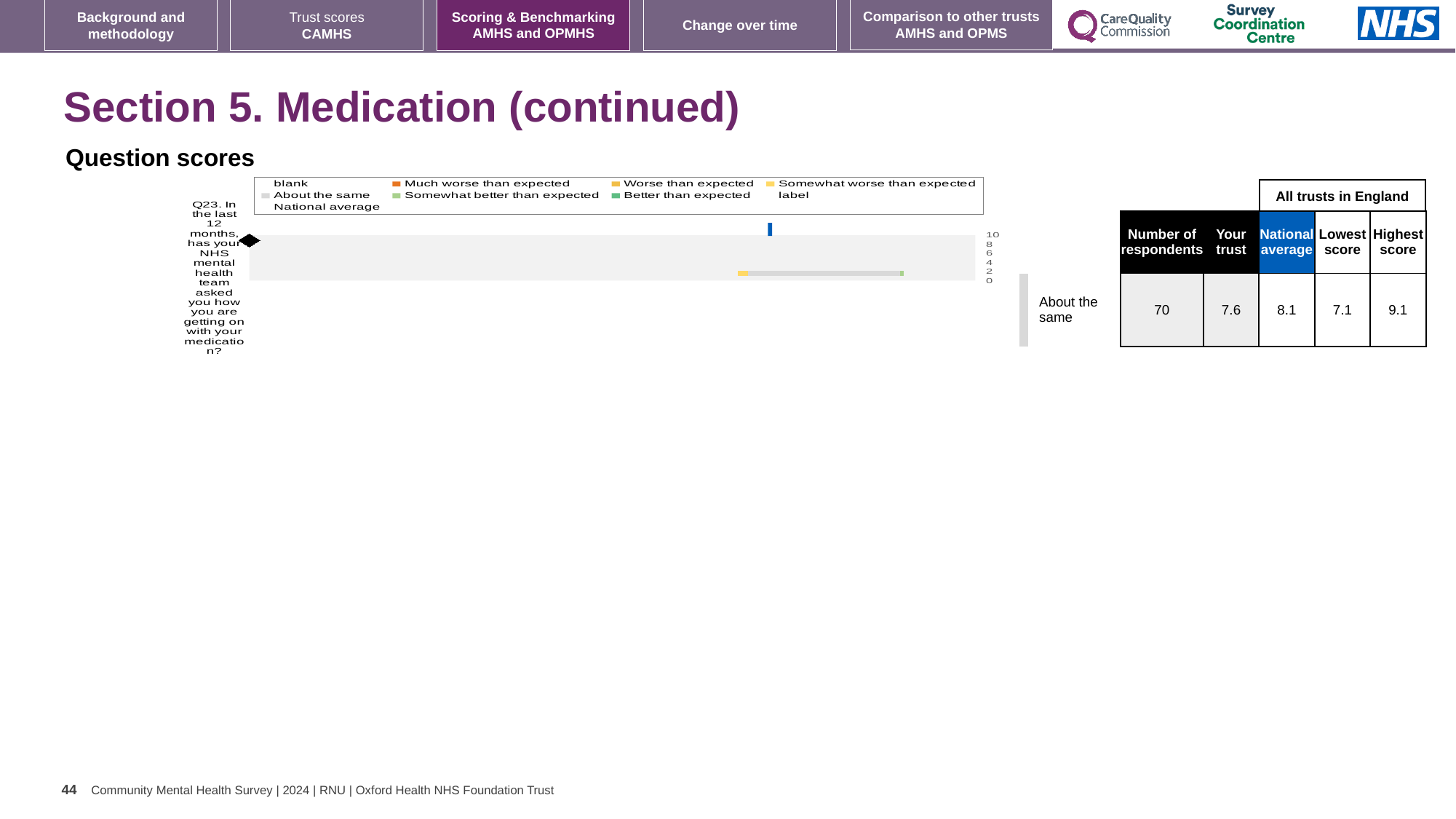
Which question number is plotted in the Question scores chart? Q23 What benchmark category is Q23 assigned in the Question scores chart? About the same What kind of chart is shown under 'Question scores'? bar chart What is the difference between the highest and lowest scores for Q23 across all trusts in England? 2.0 What is the trust's score for Q23 shown alongside the chart? 7.6 What is the lowest score among all trusts in England for Q23? 7.1 How many questions are plotted in the Question scores chart? 1 Which is larger for Q23, the trust's score or the national average? national average What is the national average score for Q23 shown alongside the chart? 8.1 What is the maximum value shown on the chart's score axis? 10 How many respondents answered Q23? 70 What is the highest score among all trusts in England for Q23? 9.1